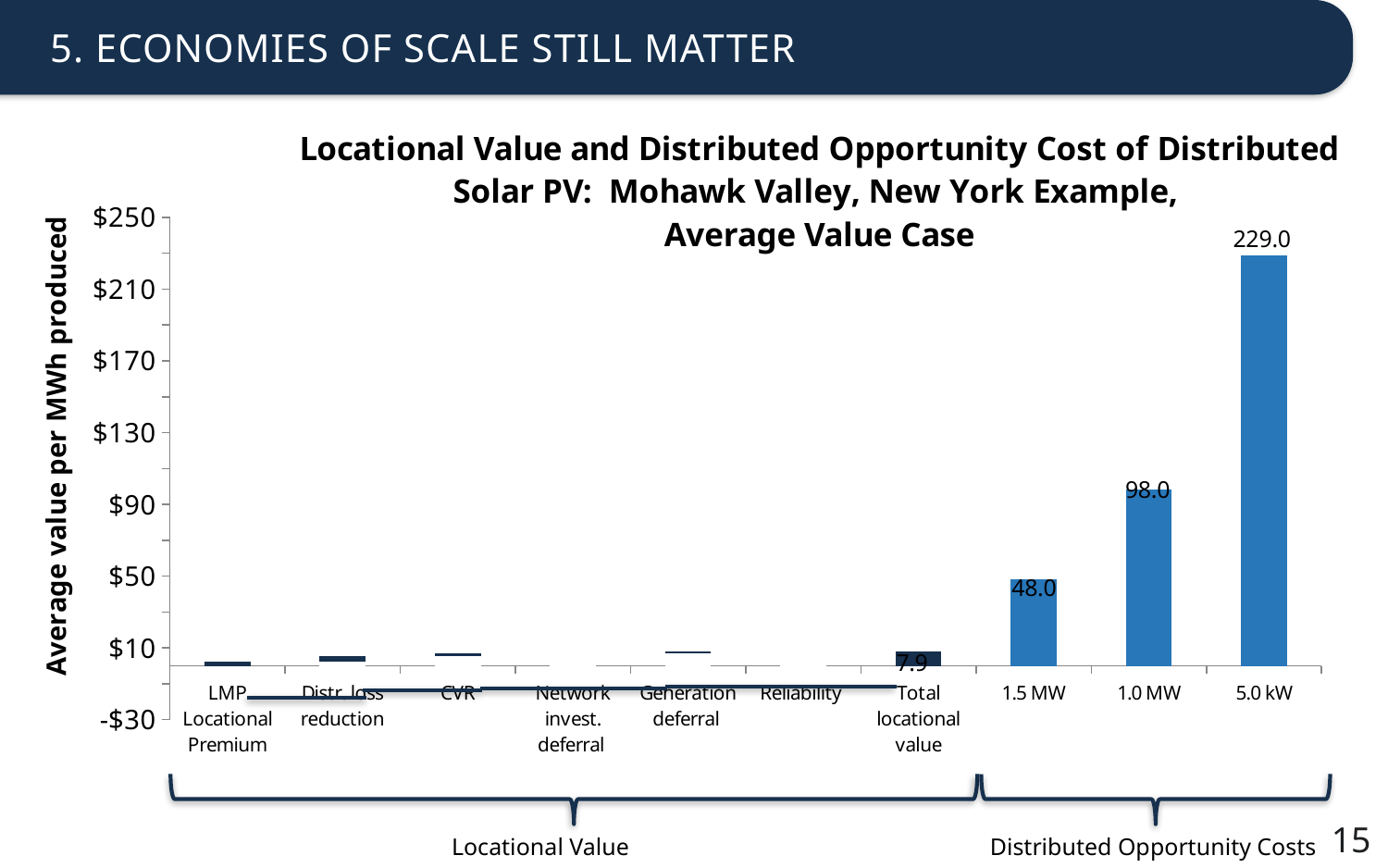
What is the value for Total locational value? 7.9 What is the value for 5.0 kW? 229.0 What is the difference between the values for 1.0 MW and 1.5 MW? 50.0 Which category has the highest value? 5.0 kW Is the value for 5.0 kW greater or less than $210? greater What is the label of the vertical axis? Average value per MWh produced What kind of chart is shown on the slide? Bar chart What is the difference between the values for 5.0 kW and 1.0 MW? 131.0 What is the value for 1.0 MW? 98.0 How many categories are shown on the x axis? 10 What is the value for 1.5 MW? 48.0 Which is larger, the value for 1.0 MW or the value for 1.5 MW? 1.0 MW